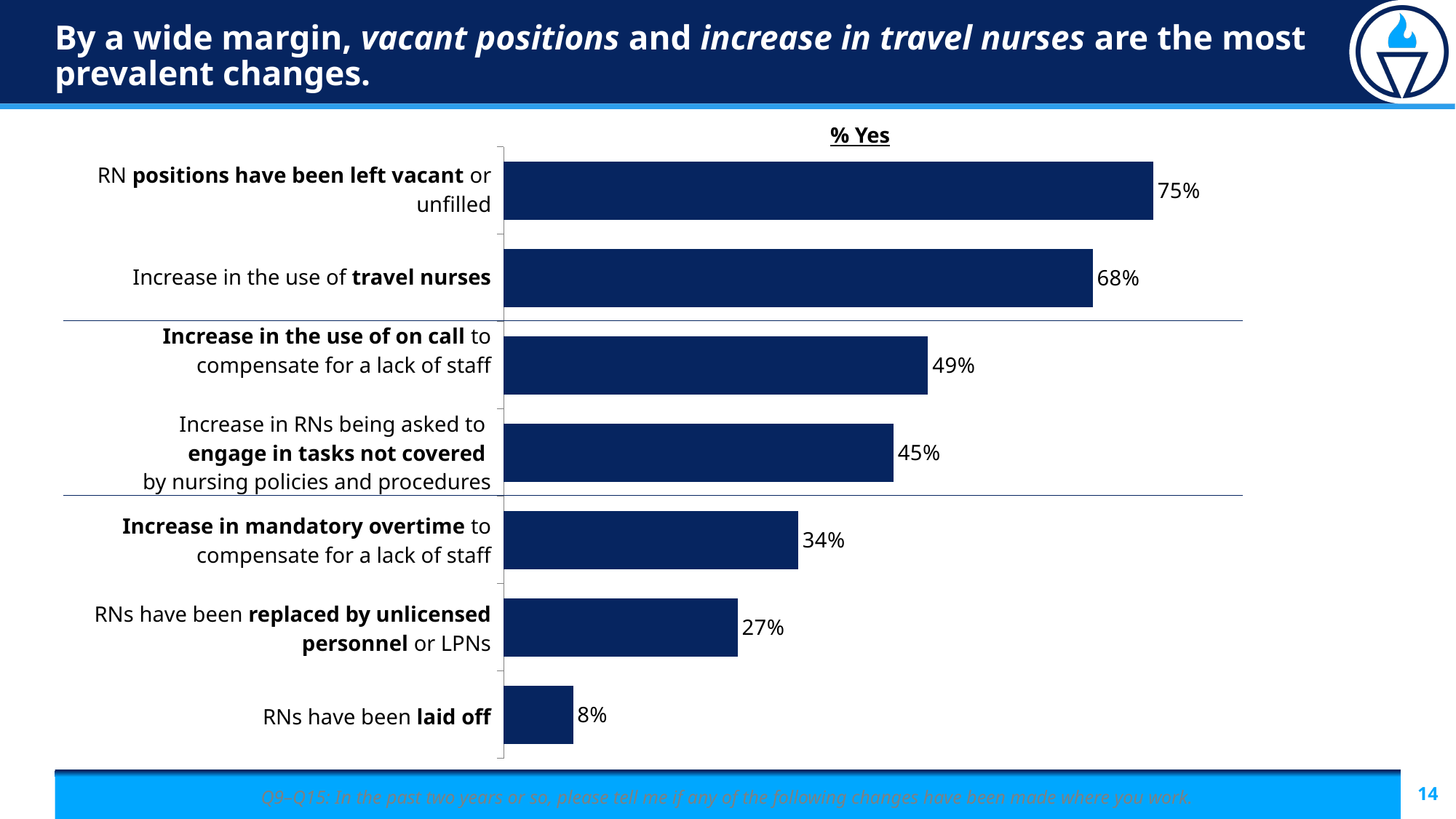
Which change has the lowest % Yes? RNs have been laid off What is the difference in percentage points between 'RN positions have been left vacant or unfilled' and 'Increase in the use of travel nurses'? 7 percentage points What percentage said RN positions have been left vacant or unfilled? 75% Which is larger: the value for 'Increase in mandatory overtime' or 'RNs have been replaced by unlicensed personnel or LPNs'? Increase in mandatory overtime Which change has the highest % Yes? RN positions have been left vacant or unfilled What is the % Yes value for 'Increase in the use of travel nurses'? 68% What percentage reported an increase in mandatory overtime to compensate for a lack of staff? 34% What is the label shown above the bars in the chart? % Yes What is the value for 'RNs have been replaced by unlicensed personnel or LPNs'? 27% How many changes (categories) are shown in the chart? 7 What type of chart is shown on the slide? Bar chart What is the difference between the value for 'Increase in the use of on call' and 'Increase in RNs being asked to engage in tasks not covered by nursing policies and procedures'? 4 percentage points